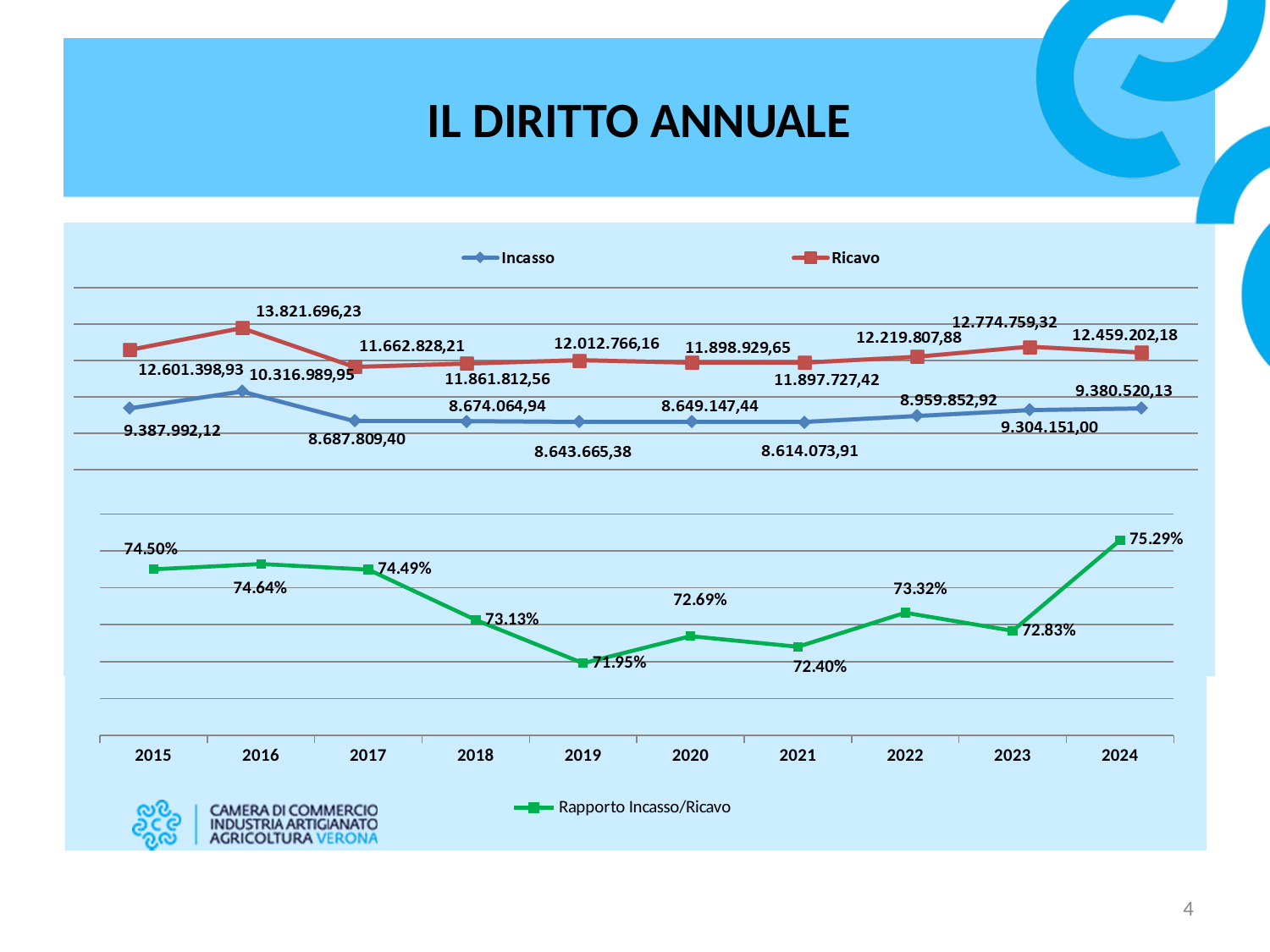
In the top chart (Incasso and Ricavo), what is the Ricavo value for 2016? 13.821.696,23 What kind of chart is the bottom chart (Rapporto Incasso/Ricavo)? line chart In the bottom chart (Rapporto Incasso/Ricavo), how many years are plotted on the x axis? 10 In the bottom chart (Rapporto Incasso/Ricavo), which year has the highest value? 2024 In the bottom chart (Rapporto Incasso/Ricavo), what is the value for 2019? 71.95% In the bottom chart (Rapporto Incasso/Ricavo), is the value for 2022 larger or smaller than the value for 2023? larger In the top chart (Incasso and Ricavo), which year has the lowest Incasso value? 2021 In the top chart (Incasso and Ricavo), which year has the highest Ricavo value? 2016 In the top chart (Incasso and Ricavo), what is the Incasso value for 2024? 9.380.520,13 In the top chart (Incasso and Ricavo), what is the difference between Ricavo and Incasso in 2016? 3.504.706,28 In the top chart (Incasso and Ricavo), how many series does the legend list? 2 In the bottom chart (Rapporto Incasso/Ricavo), which year has the lowest value? 2019